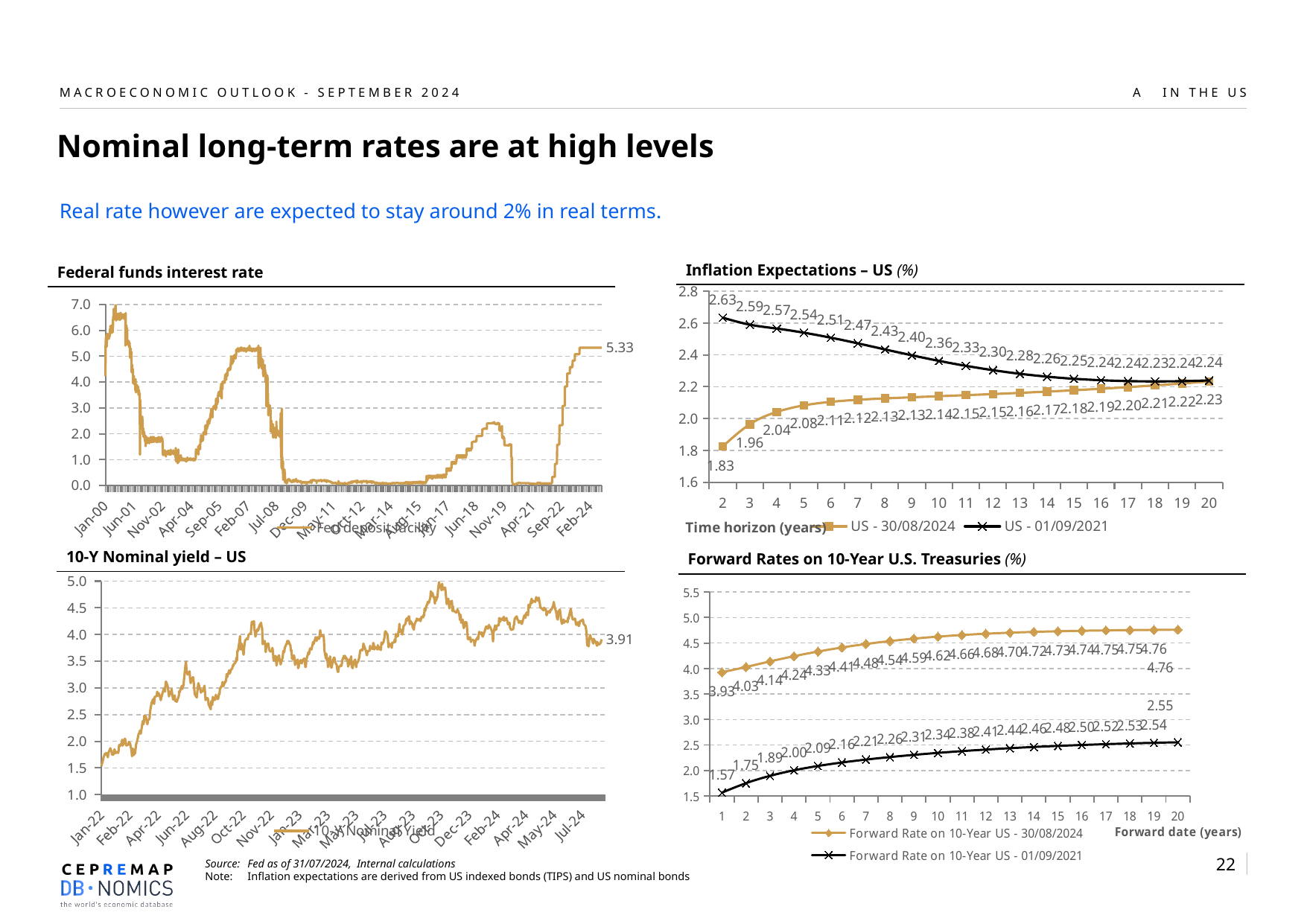
On the Federal funds interest rate chart, what is the latest value labeled at the end of the line? 5.33 On the Inflation Expectations – US chart, which series is higher at the 10-year horizon, US - 30/08/2024 or US - 01/09/2021? US - 01/09/2021 On the Forward Rates on 10-Year U.S. Treasuries chart, what is the value for Forward Rate on 10-Year US - 30/08/2024 at a forward date of 20 years? 4.76 On the Inflation Expectations – US chart, what is the value for US - 01/09/2021 at a 2-year time horizon? 2.63 On the Forward Rates on 10-Year U.S. Treasuries chart, what is the value for Forward Rate on 10-Year US - 01/09/2021 at a forward date of 1 year? 1.57 What kind of chart is the Federal funds interest rate chart? Line chart On the Forward Rates on 10-Year U.S. Treasuries chart, what is the difference between the 30/08/2024 and 01/09/2021 forward rates at 20 years? 2.21 On the 10-Y Nominal yield – US chart, what is the value labeled at the end of the line? 3.91 On the Inflation Expectations – US chart, what is the value for US - 30/08/2024 at a 2-year time horizon? 1.83 How many series does the legend of the Forward Rates on 10-Year U.S. Treasuries chart list? 2 On the Inflation Expectations – US chart, does the US - 01/09/2021 series rise or fall as the time horizon increases? Falls On the Inflation Expectations – US chart, what is the difference between the US - 01/09/2021 and US - 30/08/2024 values at the 2-year horizon? 0.80